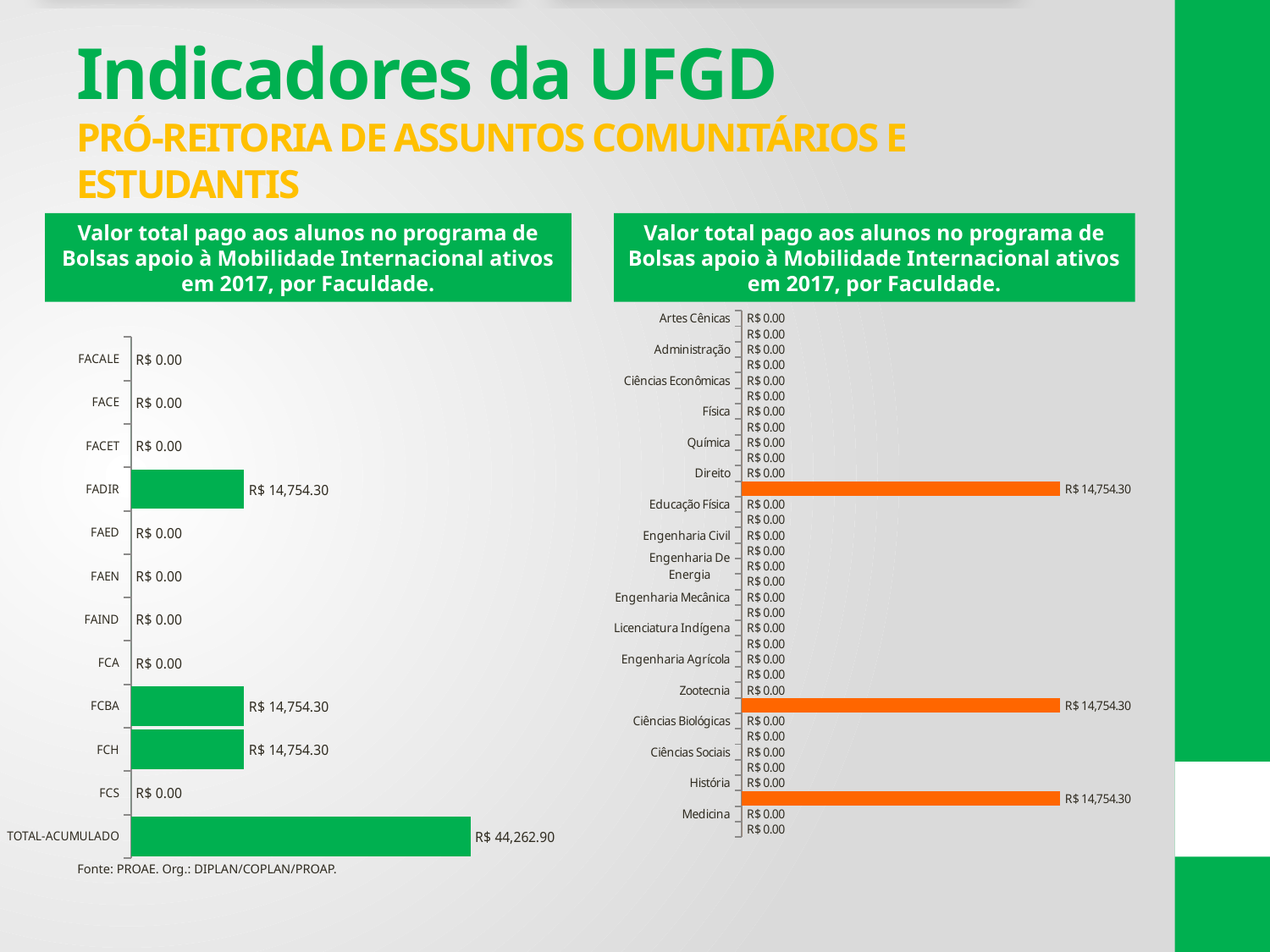
In the left chart, which is larger, the value for FCBA or the value for FCS? FCBA How many categories are shown in the left chart? 12 What colour are the bars in the right chart? Orange In the left chart, how many categories have a value of R$ 14,754.30? 3 What kind of chart is the left chart? Bar chart In the left chart, which category has the highest value? TOTAL-ACUMULADO In the left chart, what is the difference between the value for TOTAL-ACUMULADO and the value for FCH? R$ 29,508.60 In the right chart, what is the value for Direito? R$ 0.00 In the left chart, what is the value for FACE? R$ 0.00 In the left chart, what is the value for TOTAL-ACUMULADO? R$ 44,262.90 In the right chart, what is the value for Medicina? R$ 0.00 In the left chart, what is the value for FADIR? R$ 14,754.30